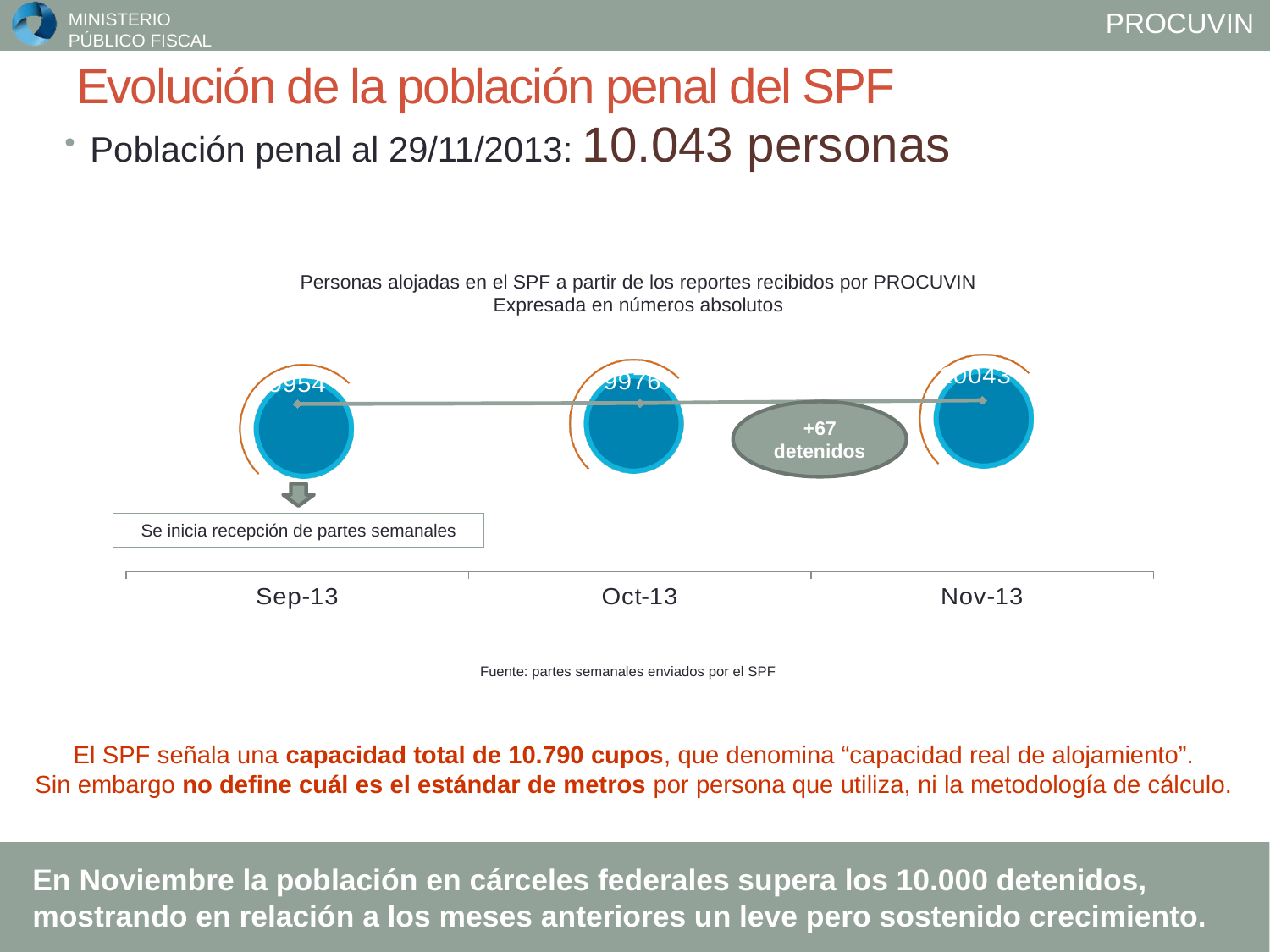
How many data points (months) are plotted on the chart? 3 What source is cited below the chart? Fuente: partes semanales enviados por el SPF Is the value for Nov-13 greater or less than 10000? greater What is the value plotted for Nov-13? 10043 What is the title of the chart? Personas alojadas en el SPF a partir de los reportes recibidos por PROCUVIN Expresada en números absolutos Which month has the highest value on the chart? Nov-13 What type of chart is shown on the slide? line chart By how many detenidos did the population increase between Oct-13 and Nov-13, according to the annotation on the chart? +67 detenidos Do the values rise or fall from Sep-13 to Nov-13? rise Which month has the lowest value on the chart? Sep-13 What is the value plotted for Oct-13? 9976 Is the value for Sep-13 greater or less than 10000? less